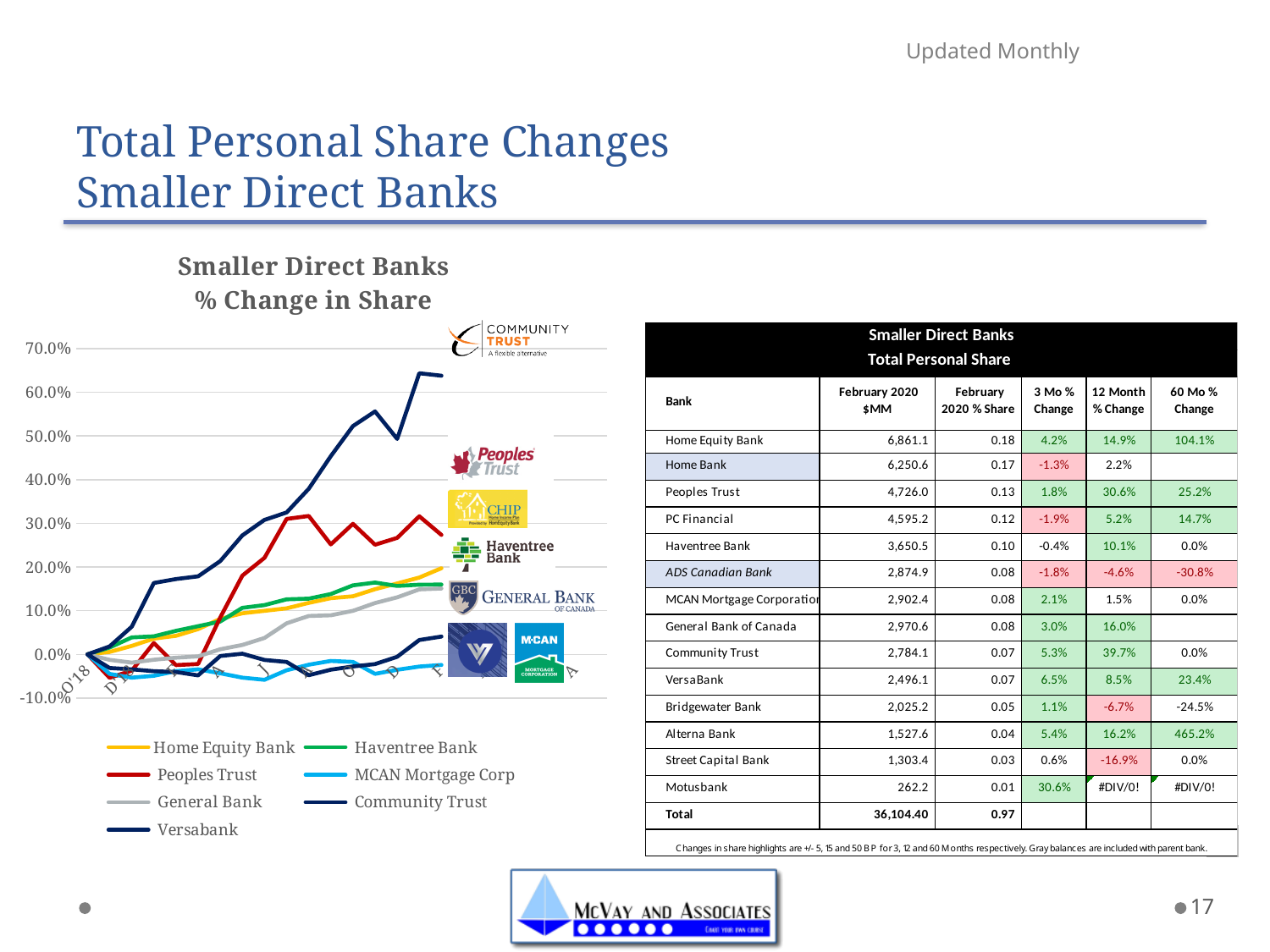
Is the peak value for Peoples Trust greater or less than 40.0%? less Is the final value for Peoples Trust greater or less than 20.0%? greater Is the final value for MCAN Mortgage Corp greater or less than 10.0%? less Which series ends higher at the right of the chart, Versabank or MCAN Mortgage Corp? Versabank What colour is the Peoples Trust line in the legend? red Which series reaches the highest value on the chart? Community Trust Does the Community Trust line generally rise or fall across the x axis? rise How many series does the chart legend list? 7 Which series ends higher at the right of the chart, Peoples Trust or Home Equity Bank? Peoples Trust What kind of chart is shown on the slide? line chart What is the title of the chart? Smaller Direct Banks % Change in Share